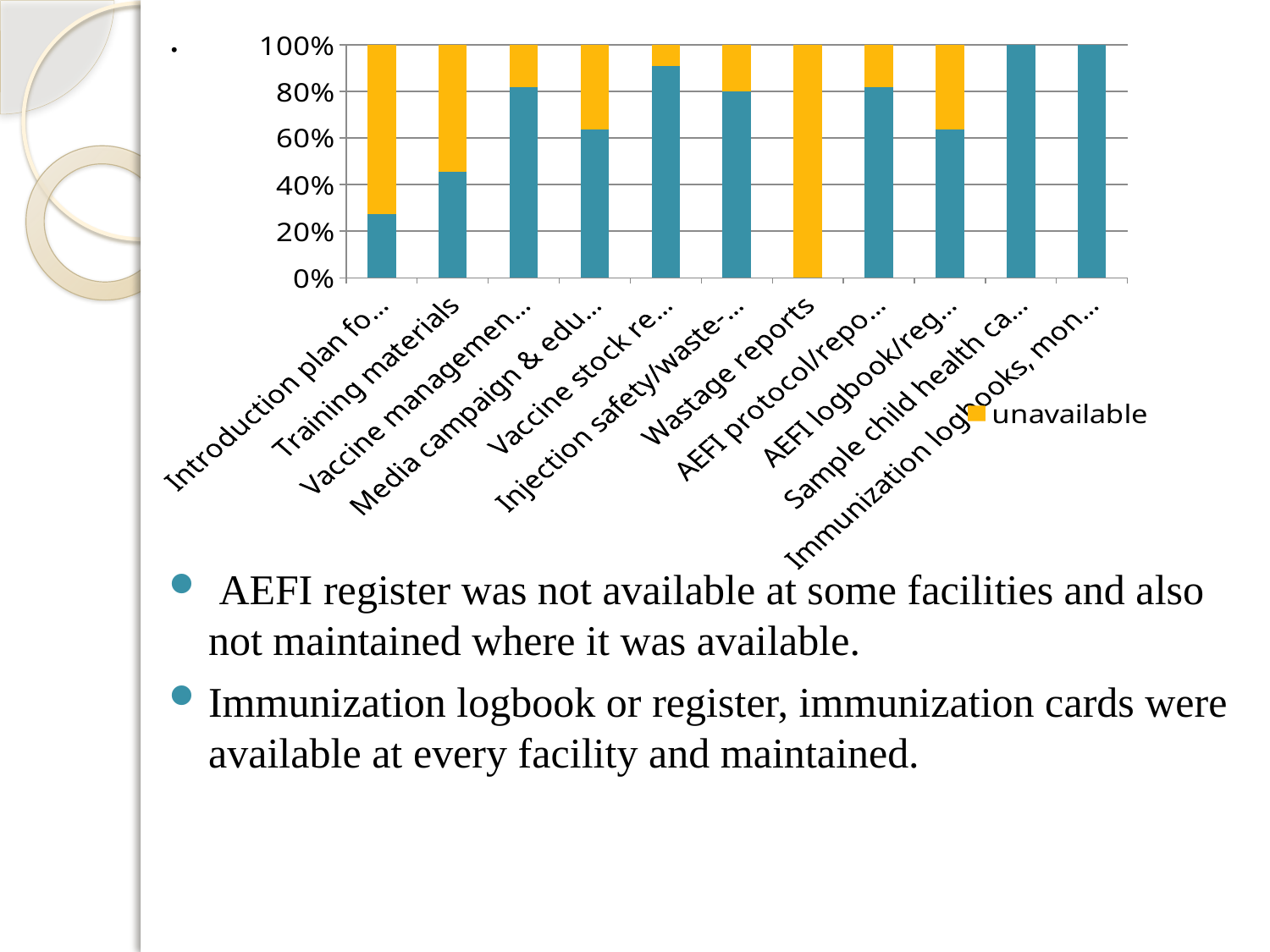
Is the 'unavailable' value for Vaccine stock re... greater or less than 20%? less What kind of chart is shown on the slide? Stacked bar chart What is the only entry shown in the chart's legend? unavailable Is the 'unavailable' value for Training materials greater or less than 40%? greater What is the 'unavailable' value for Wastage reports? 100% How many series does the chart's legend list? 1 Is the 'unavailable' value for Introduction plan fo... greater or less than 60%? greater Which has the larger 'unavailable' value, Training materials or Vaccine managemen...? Training materials Which category has the highest 'unavailable' value? Wastage reports How many categories are plotted along the x axis of the chart? 11 What colour represents the 'unavailable' series in the chart? Yellow Which category has the smallest teal (non-'unavailable') portion of its bar? Wastage reports